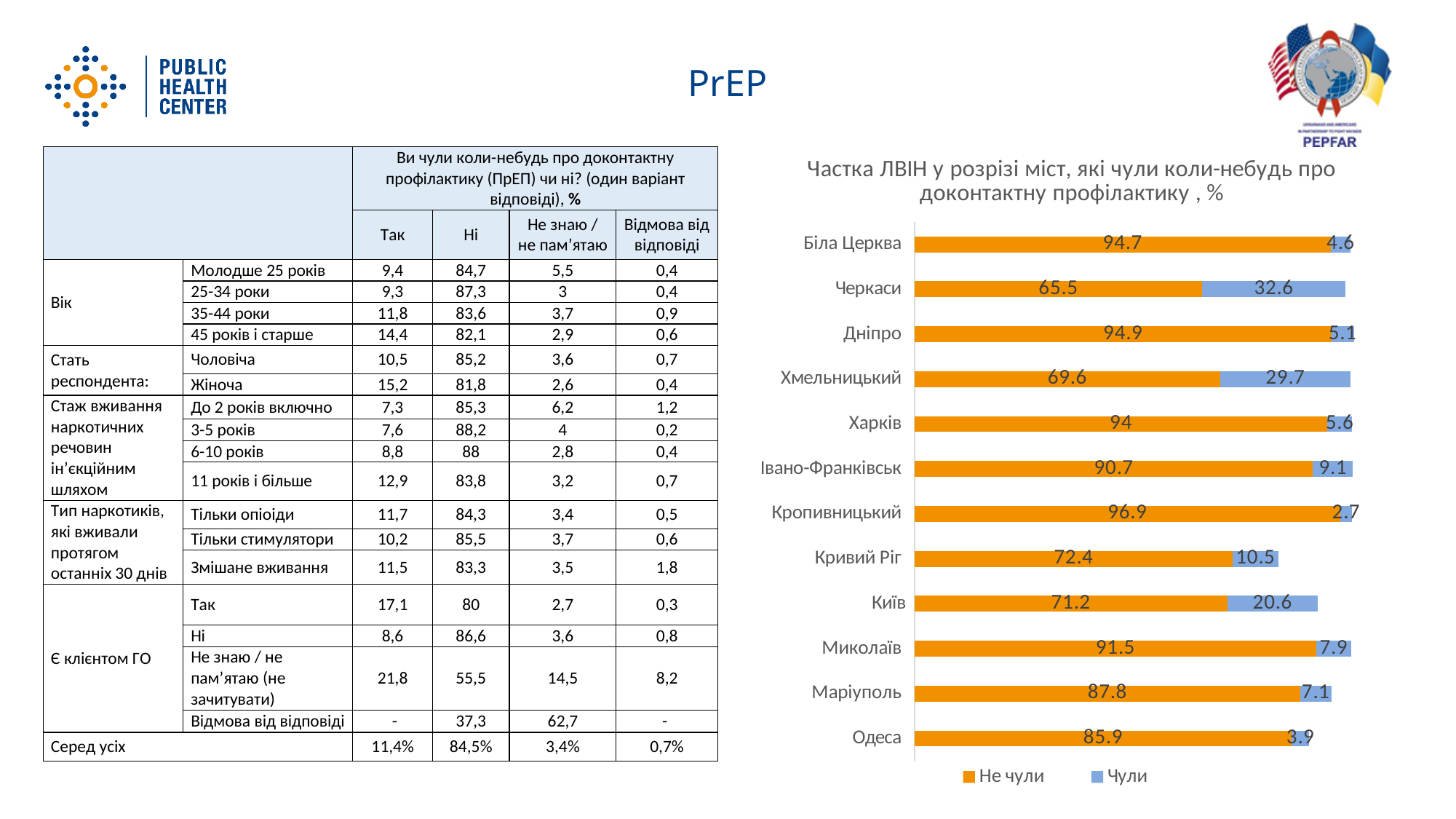
In the chart, what is the value of "Чули" for Київ? 20.6 In the chart, which is larger: the "Чули" value for Хмельницький or for Київ? Хмельницький In the chart, which city has the lowest value for "Чули"? Кропивницький In the chart, which city has the highest value for "Чули"? Черкаси How many series does the chart legend list? 2 How many cities are shown in the chart? 12 In the chart, what is the value of "Не чули" for Черкаси? 65.5 In the chart, what is the value of "Не чули" for Кропивницький? 96.9 In the chart, which city has the lowest value for "Не чули"? Черкаси What kind of chart is shown on the right of the slide? Stacked bar chart In the chart, what is the total of the stacked bar for Черкаси? 98.1 In the chart, what is the difference between the "Чули" values for Київ and Кривий Ріг? 10.1